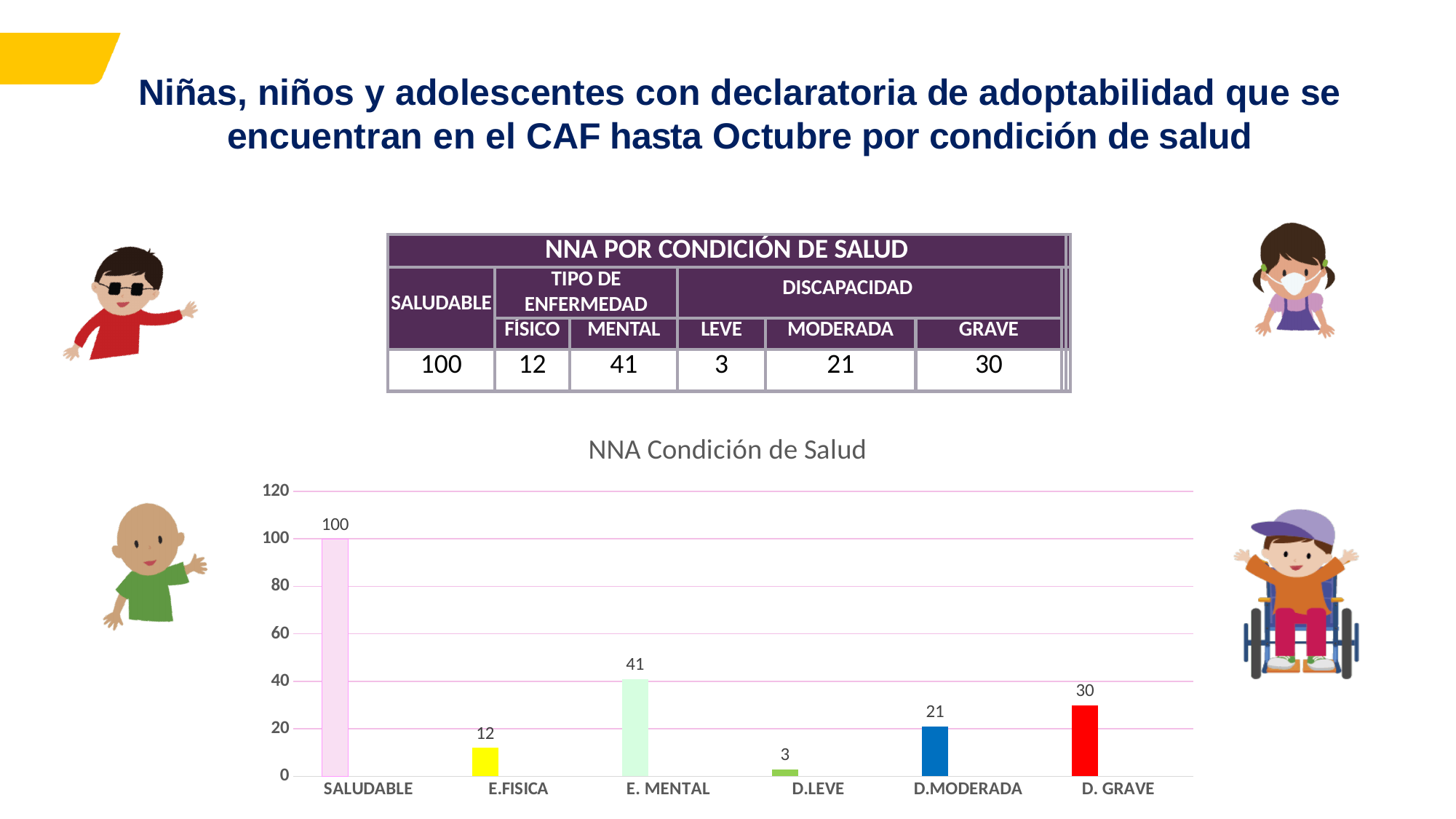
What is the value for SALUDABLE in the chart? 100 Which category has the lowest value in the chart? D.LEVE What is the value for E. MENTAL in the chart? 41 Which category has the highest value in the chart? SALUDABLE Is the value for E.FISICA greater or less than 20? less What is the value for D.MODERADA in the chart? 21 Which is larger, the value for D. GRAVE or the value for E. MENTAL? E. MENTAL How many categories are shown on the x axis of the chart? 6 What is the title of the chart? NNA Condición de Salud What kind of chart is shown on the slide? bar chart What is the difference between the values for E. MENTAL and E.FISICA? 29 What is the difference between the values for D. GRAVE and D.MODERADA? 9